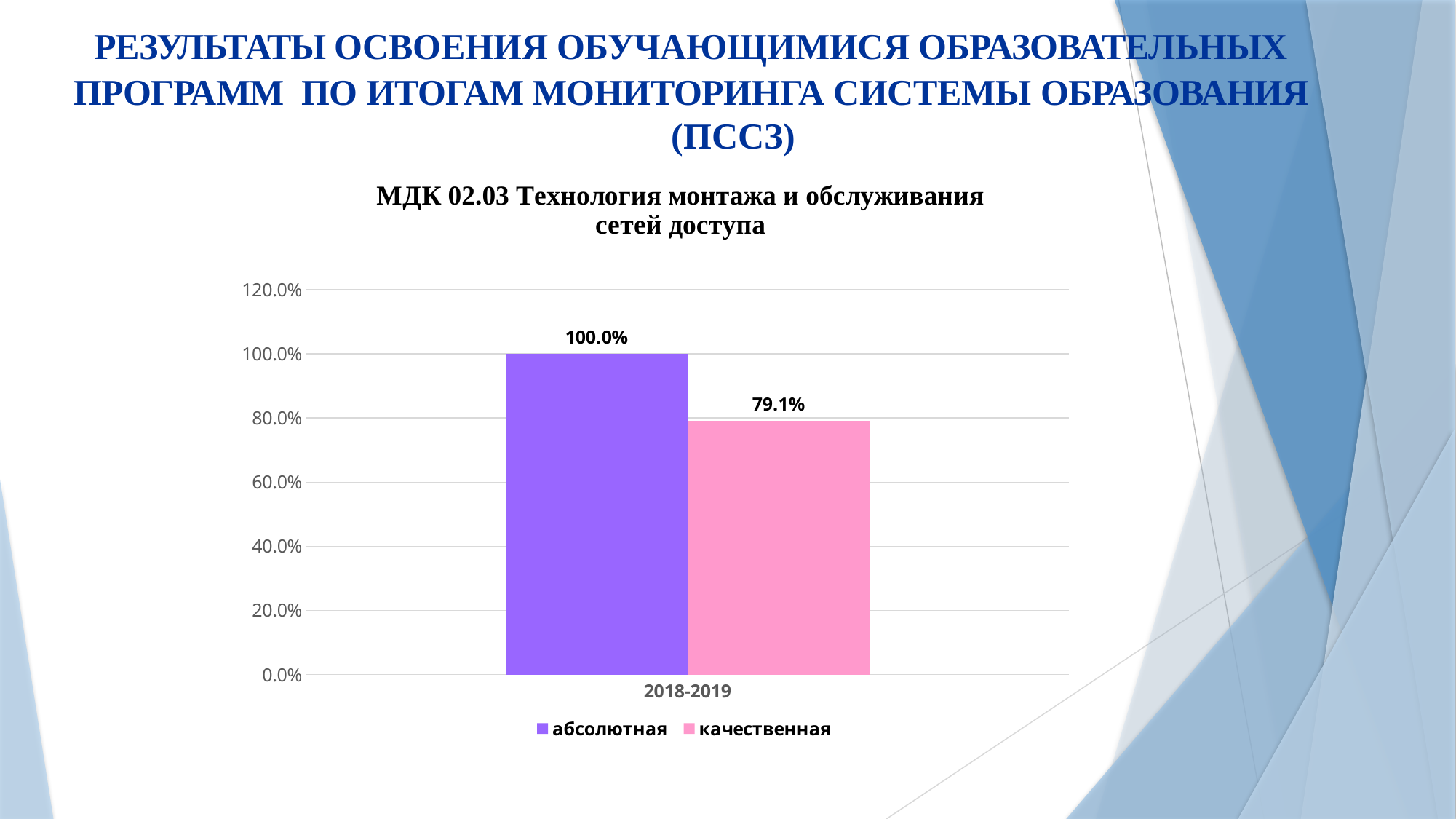
What is the value of the абсолютная series for 2018-2019? 100.0% Is the value for качественная in 2018-2019 greater or less than 80.0%? less How many series does the legend list? 2 Which series has the higher value for 2018-2019, абсолютная or качественная? абсолютная What kind of chart is shown on the slide? bar chart What colour is the bar for the качественная series? pink What is the difference between the абсолютная and качественная values for 2018-2019? 20.9% Is the value for абсолютная in 2018-2019 greater or less than 80.0%? greater What is the title of the chart? МДК 02.03 Технология монтажа и обслуживания сетей доступа Which series has the lowest value in the chart? качественная How many categories are shown on the x axis? 1 What is the value of the качественная series for 2018-2019? 79.1%